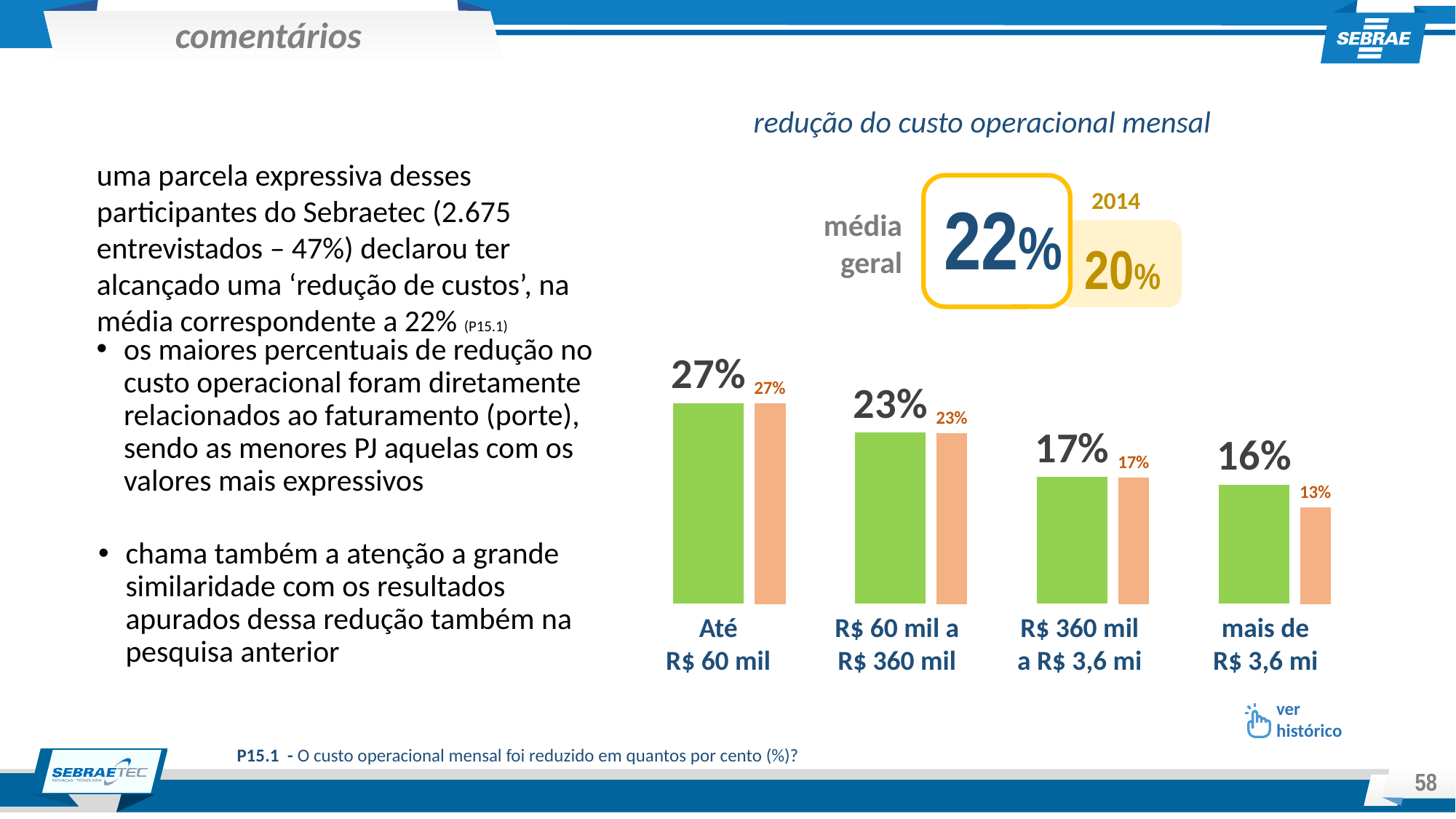
How many revenue categories are shown in the chart? 4 What is the value of the green bar for 'Até R$ 60 mil'? 27% Which category has the lowest 2014 (orange) value? mais de R$ 3,6 mi What is the green bar value for 'R$ 360 mil a R$ 3,6 mi'? 17% What was the 'média geral' value for 2014? 20% What is the difference between the green bar values for 'Até R$ 60 mil' and 'R$ 60 mil a R$ 360 mil'? 4% What is the difference between the green bar and the 2014 bar for 'mais de R$ 3,6 mi'? 3% What type of chart is shown on the slide? bar chart Which category has the highest green bar value? Até R$ 60 mil What is the 'média geral' value shown in the highlighted box? 22% Do the green bar values rise or fall from left to right across the categories? fall What is the 2014 (orange) value for 'mais de R$ 3,6 mi'? 13%